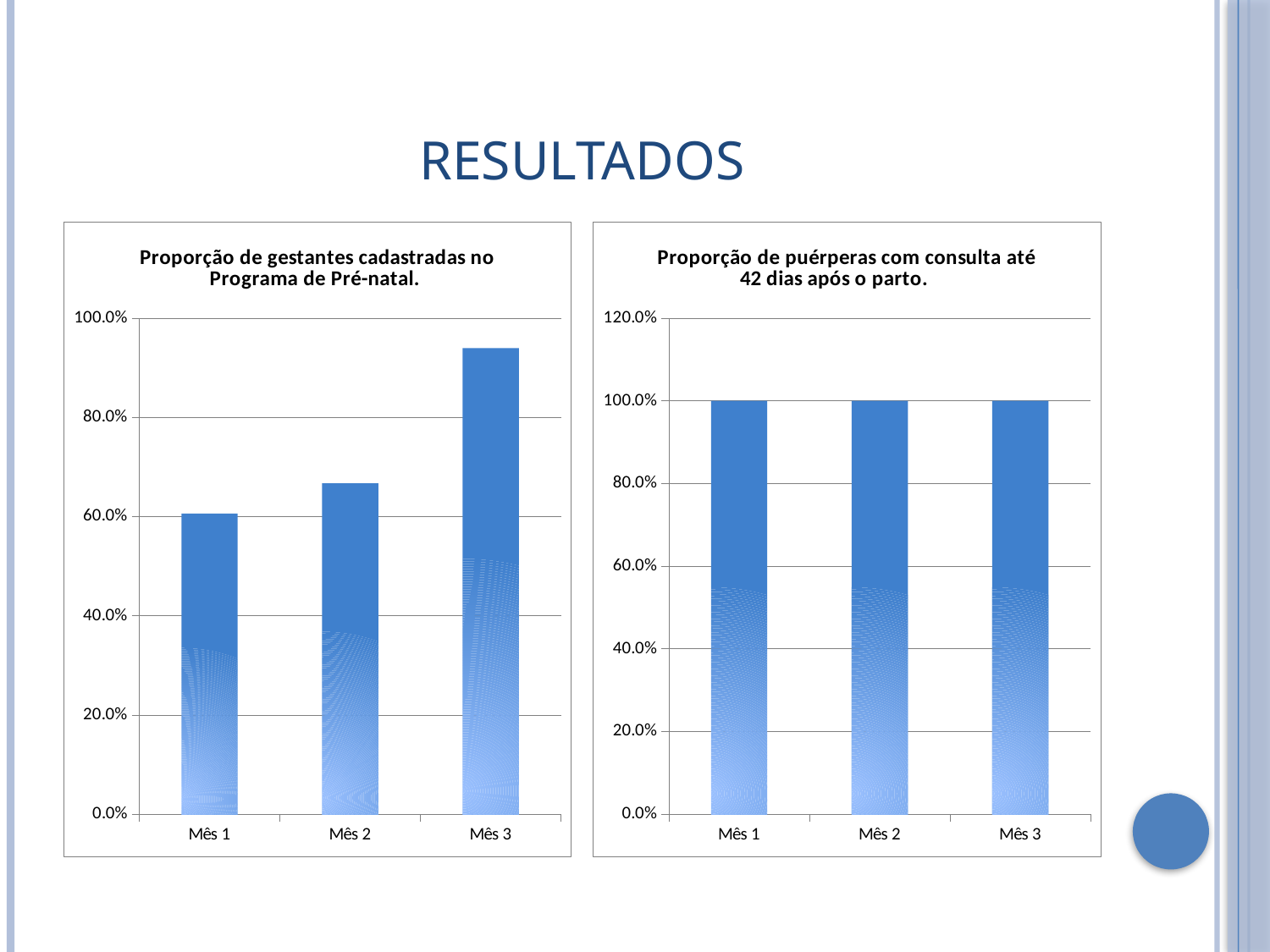
In the left chart, is the value for Mês 3 greater or less than 80.0%? greater What kind of chart is the left chart on the slide? bar chart In the chart titled "Proporção de gestantes cadastradas no Programa de Pré-natal.", which month has the lowest value? Mês 1 In the chart titled "Proporção de gestantes cadastradas no Programa de Pré-natal.", which month has the highest value? Mês 3 In the left chart, is the value for Mês 2 greater or less than 60.0%? greater In the right chart, how many months are plotted? 3 In the chart titled "Proporção de puérperas com consulta até 42 dias após o parto.", what is the value for Mês 3? 100.0% What is the title of the right chart? Proporção de puérperas com consulta até 42 dias após o parto. In the left chart, which is larger, the value for Mês 2 or the value for Mês 3? Mês 3 In the chart titled "Proporção de puérperas com consulta até 42 dias após o parto.", what is the value for Mês 1? 100.0% In the left chart, do the values rise or fall from Mês 1 to Mês 3? rise In the left chart, is the value for Mês 1 greater or less than 80.0%? less